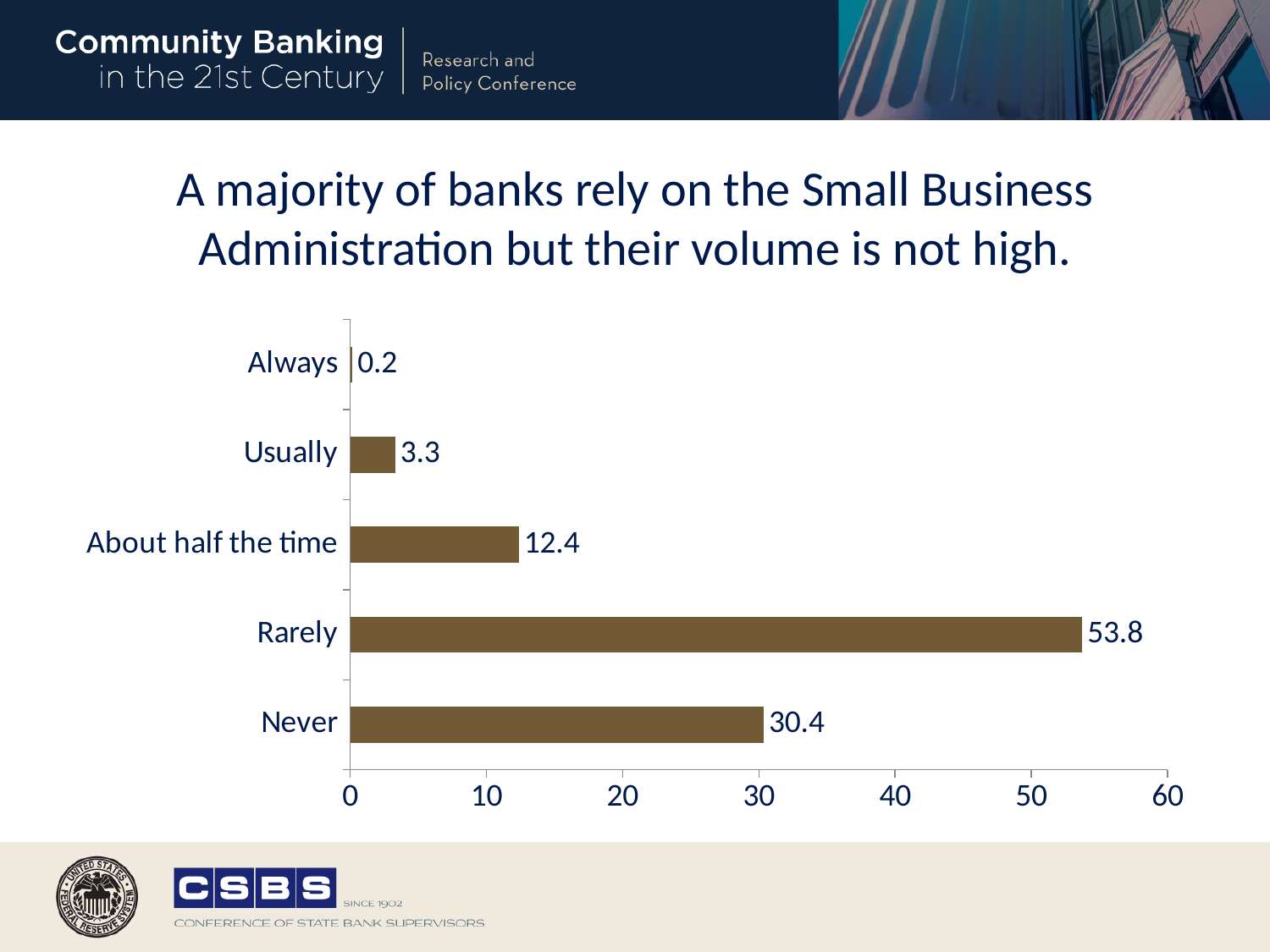
What is the value for Usually? 3.3 What is the value for Rarely? 53.8 What kind of chart is shown on the slide? Bar chart Which category has the lowest value? Always What is the value for Never? 30.4 Which category has the highest value? Rarely What is the value for About half the time? 12.4 Which is larger, the value for Never or the value for About half the time? Never How many categories are shown in the chart? 5 What is the difference between the values for Rarely and Never? 23.4 What is the value for Always? 0.2 Is the value for Rarely greater or less than 50? greater